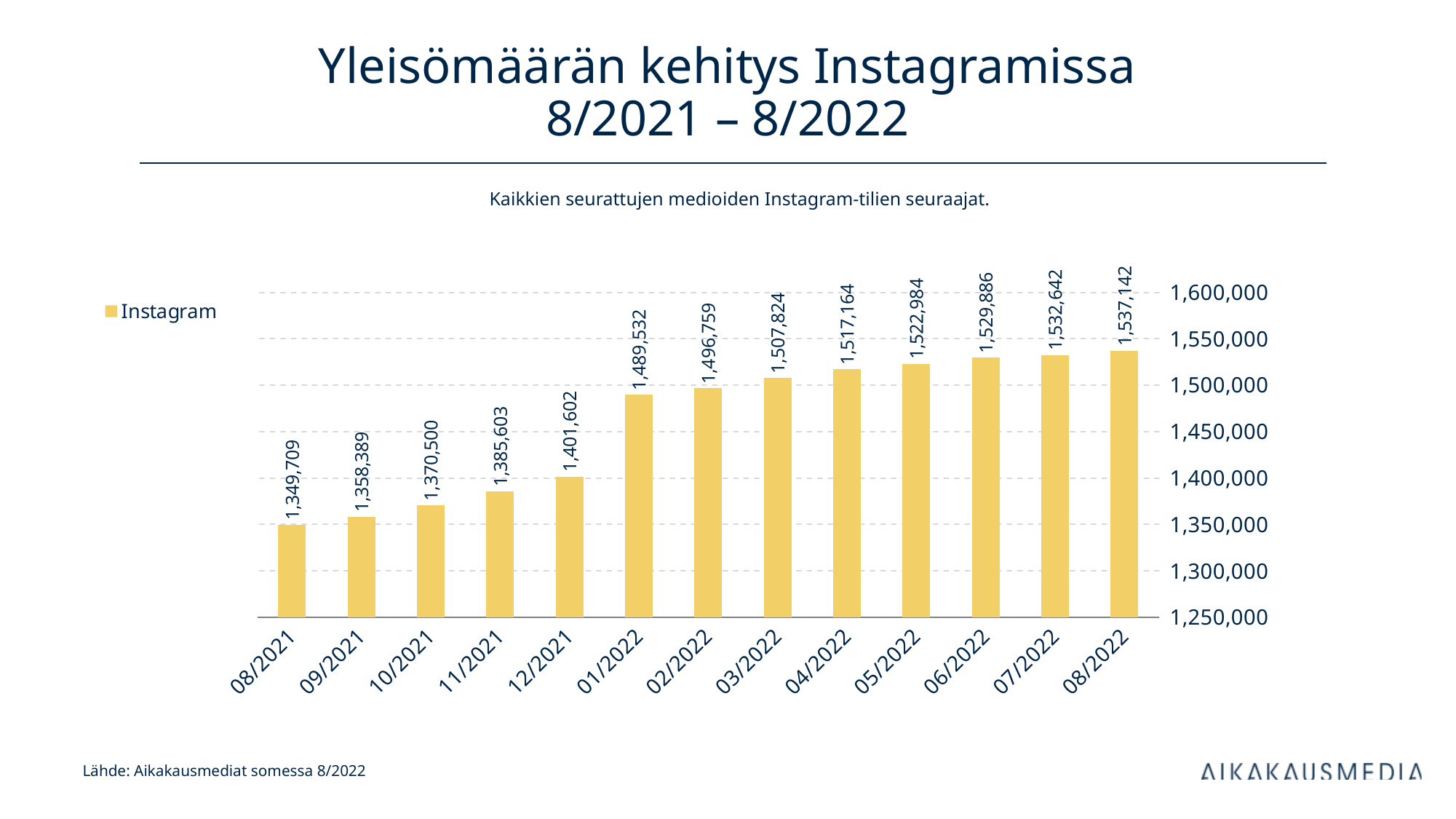
Is the value for 11/2021 greater or less than 1,400,000? less What is the value for 08/2022? 1,537,142 How many months are shown on the x axis? 13 What is the difference between the values for 01/2022 and 12/2021? 87,930 What is the value for 08/2021? 1,349,709 What kind of chart is shown? bar chart Which month has the highest value? 08/2022 Do the values rise or fall from 08/2021 to 08/2022? rise Which month has the lowest value? 08/2021 What is the difference between the values for 08/2022 and 08/2021? 187,433 What is the value for 01/2022? 1,489,532 Which is larger, the value for 12/2021 or the value for 01/2022? 01/2022